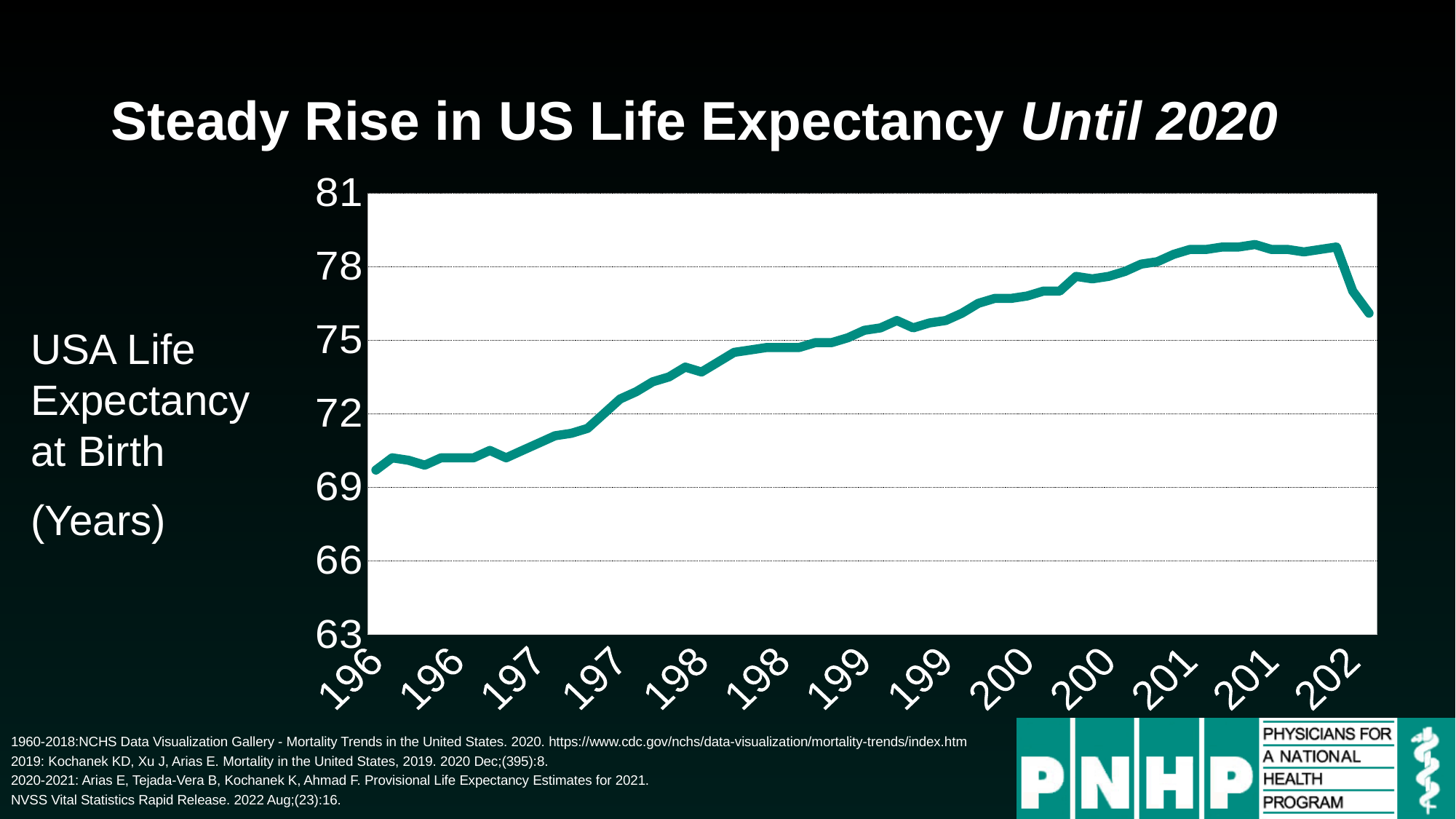
What quantity does the chart plot, according to the label to its left? USA Life Expectancy at Birth (Years) Is the value at the right end of the line greater or less than 75? greater Does the line generally rise or fall from left to right across the chart? rise Is the highest value reached by the line greater or less than 78? greater Which is larger: the value at the left end of the line or the value at the right end? the right end Is the value at the left end of the line greater or less than 69? greater What is the title of the slide? Steady Rise in US Life Expectancy Until 2020 What kind of chart is shown on the slide? line chart Is the lowest point of the line at the left end or the right end of the chart? left end At the far right end of the chart, does the line rise or fall? fall